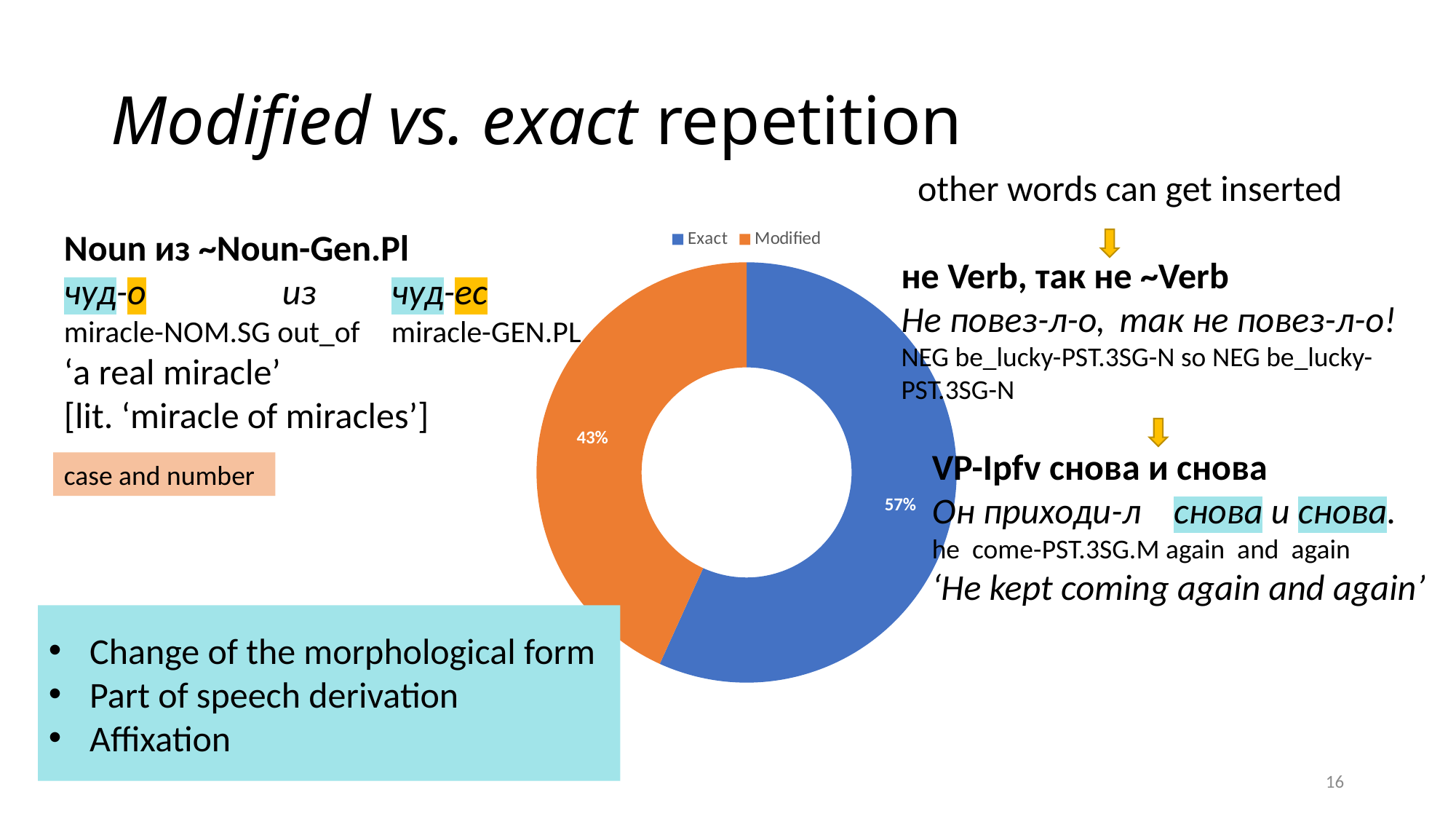
What is the difference in percentage points between the Exact and Modified shares? 14 Is the share for Modified greater or less than 50%? less How many entries does the chart legend list? 2 What colour represents the Modified category in the chart? Orange Which category has the largest share of the chart? Exact What percentage of the chart is labelled Exact? 57% What kind of chart is shown on the slide? Doughnut (pie) chart What colour represents the Exact category in the chart? Blue How many categories does the chart show? 2 Which category has the larger share of the chart, Exact or Modified? Exact Which category has the smallest share of the chart? Modified What percentage of the chart is labelled Modified? 43%